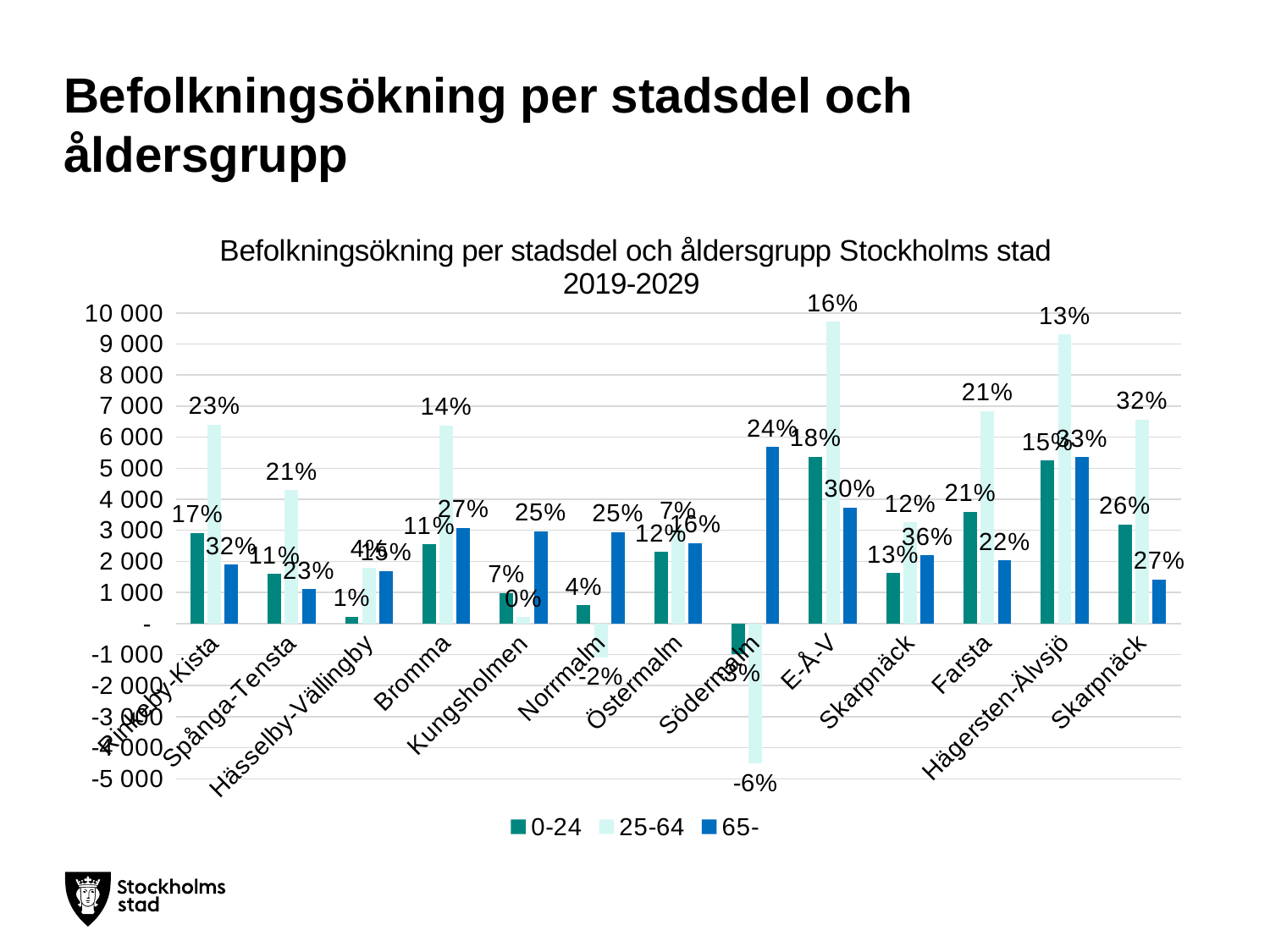
What is the data label on the 65- bar for Rinkeby-Kista? 32% How many series does the legend list? 3 Which category has the tallest 25-64 bar? E-Å-V What kind of chart is shown on the slide? bar chart What is the data label on the 25-64 bar for Bromma? 14% What is the data label on the 25-64 bar for Södermalm? -6% What are the three series listed in the legend? 0-24, 25-64, 65- What is the data label on the 65- bar for Skarpnäck (the first Skarpnäck category)? 36% Is the 25-64 bar for E-Å-V greater or less than 9 000? greater Is the 25-64 bar for Södermalm greater or less than -4 000? less Which category has the lowest 25-64 bar? Södermalm What is the data label on the 0-24 bar for E-Å-V? 18%